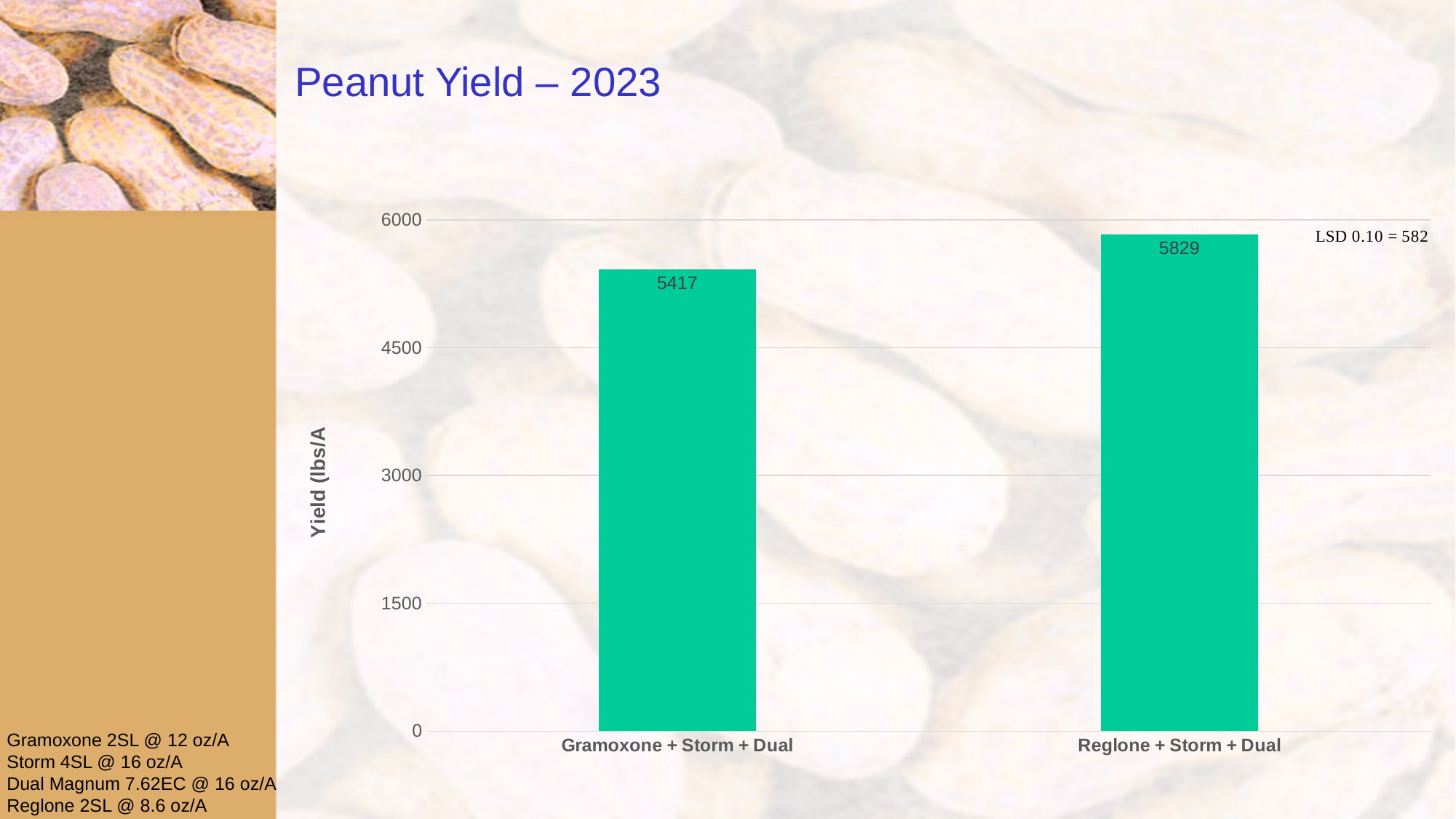
What kind of chart is shown on the slide? bar chart What is the yield for Reglone + Storm + Dual? 5829 What is the label of the y axis? Yield (lbs/A What is the yield for Gramoxone + Storm + Dual? 5417 Is the yield for Gramoxone + Storm + Dual greater or less than 6000? less What is the title of the chart? Peanut Yield – 2023 Which has a larger yield, Gramoxone + Storm + Dual or Reglone + Storm + Dual? Reglone + Storm + Dual Which treatment has the highest yield? Reglone + Storm + Dual Is the yield for Reglone + Storm + Dual greater or less than 4500? greater What is the difference in yield between Reglone + Storm + Dual and Gramoxone + Storm + Dual? 412 How many treatments are shown in the chart? 2 Which treatment has the lowest yield? Gramoxone + Storm + Dual